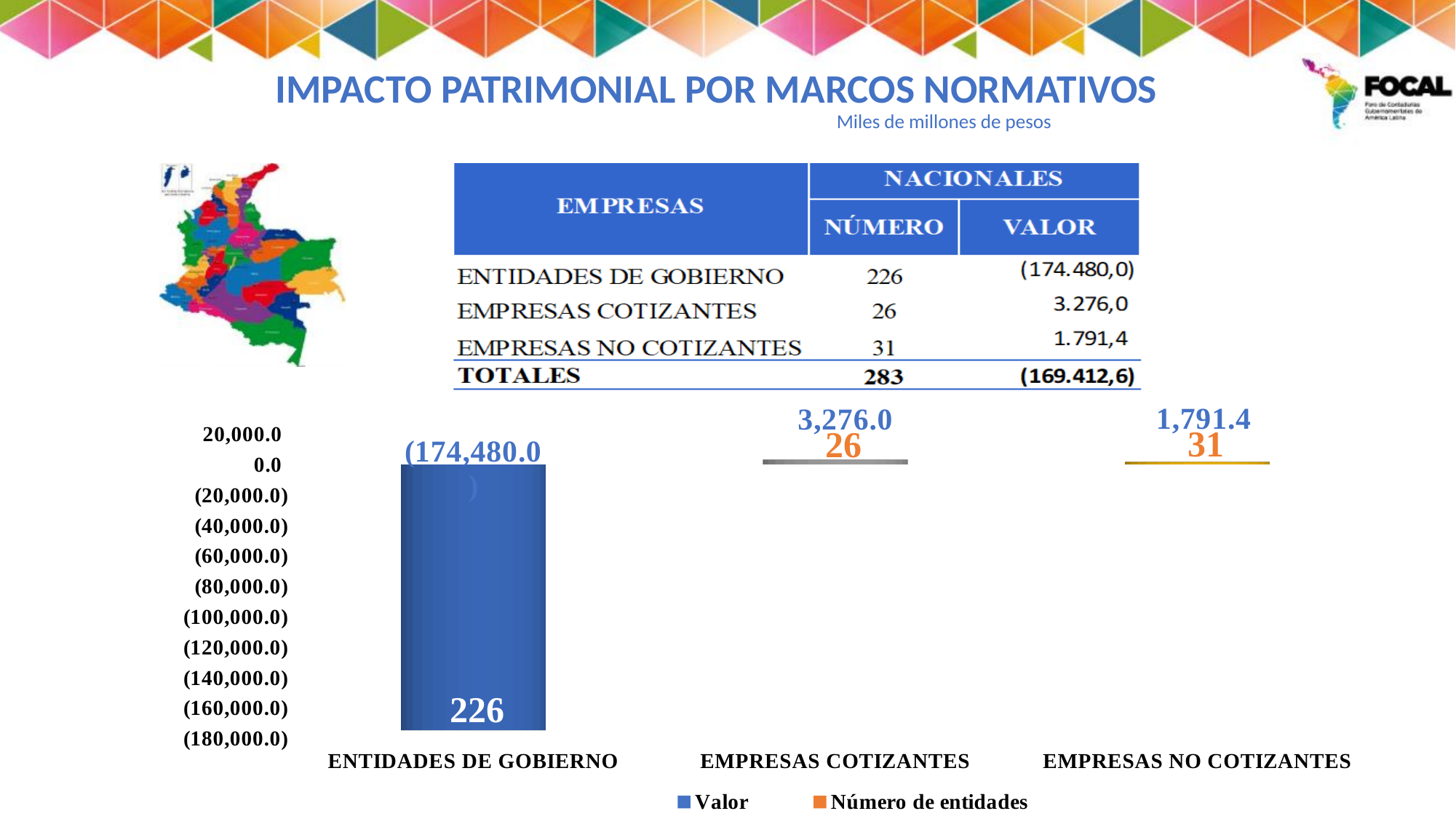
What is the Valor data label for ENTIDADES DE GOBIERNO in the chart? (174,480.0) Which category has the lowest Número de entidades in the chart? EMPRESAS COTIZANTES What is the Número de entidades value for ENTIDADES DE GOBIERNO in the chart? 226 What type of chart is shown on the slide? bar chart What is the difference between the Número de entidades for EMPRESAS NO COTIZANTES and EMPRESAS COTIZANTES? 5 How many categories are shown on the x axis of the chart? 3 Which category has the highest Número de entidades in the chart? ENTIDADES DE GOBIERNO What is the Valor data label for EMPRESAS NO COTIZANTES in the chart? 1,791.4 Which series is shown in blue in the chart legend? Valor What is the Valor data label for EMPRESAS COTIZANTES in the chart? 3,276.0 What is the Número de entidades value for EMPRESAS NO COTIZANTES in the chart? 31 How many series does the chart legend list? 2